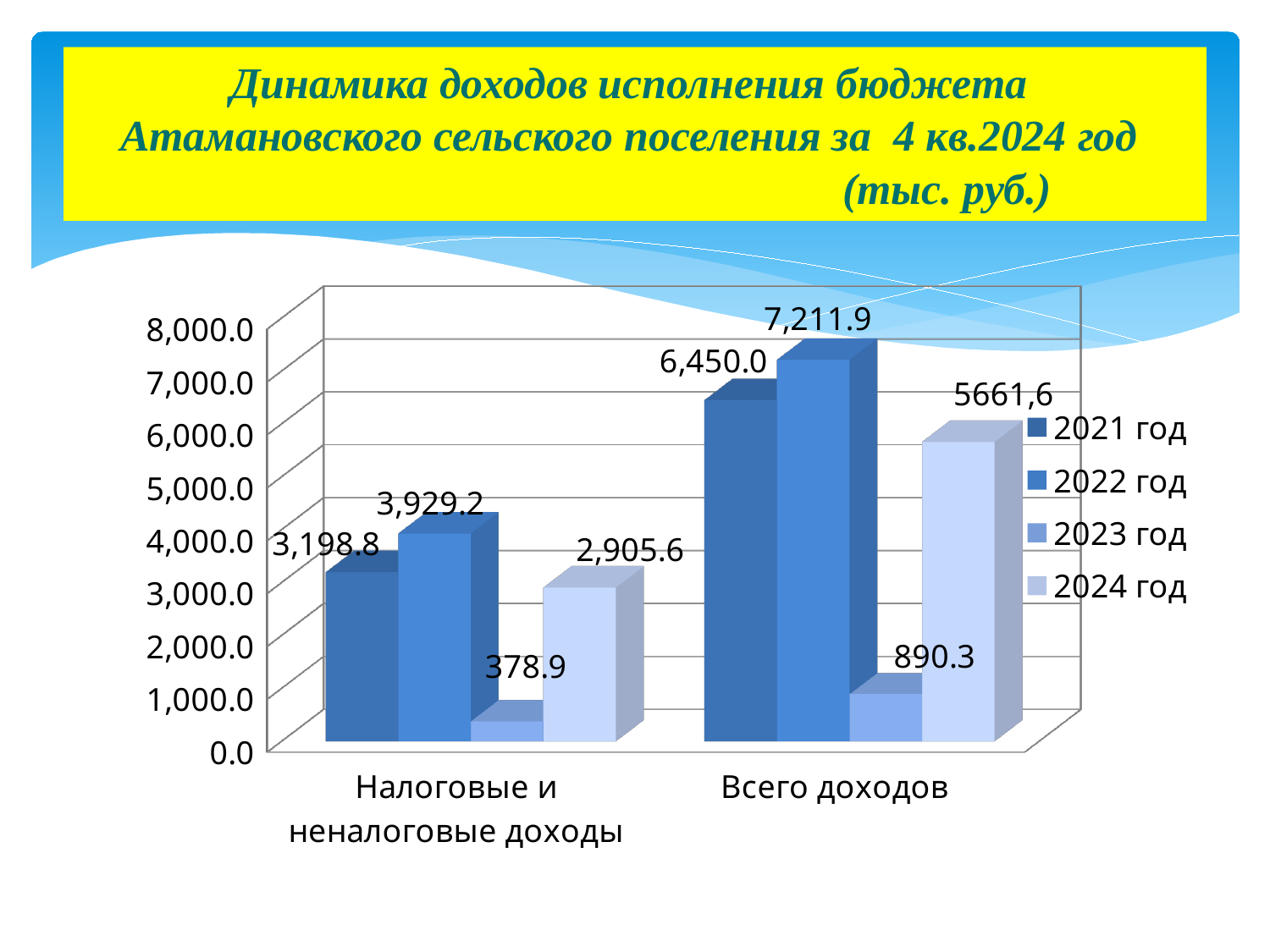
Which is larger in the category Всего доходов: the value for 2021 год or the value for 2024 год? 2021 год What kind of chart is shown on the slide? Bar chart What is the difference between the 2022 год and 2021 год values in the category Налоговые и неналоговые доходы? 730.4 What is the value for 2024 год in the category Всего доходов? 5661,6 What is the value for 2021 год in the category Налоговые и неналоговые доходы? 3,198.8 What is the value for 2022 год in the category Всего доходов? 7,211.9 How many categories are shown on the x axis? 2 How many series does the legend list? 4 Which year has the highest value in the category Всего доходов? 2022 год What is the value for 2023 год in the category Налоговые и неналоговые доходы? 378.9 What is the difference between the 2022 год and 2021 год values in the category Всего доходов? 761.9 Which year has the lowest value in the category Налоговые и неналоговые доходы? 2023 год